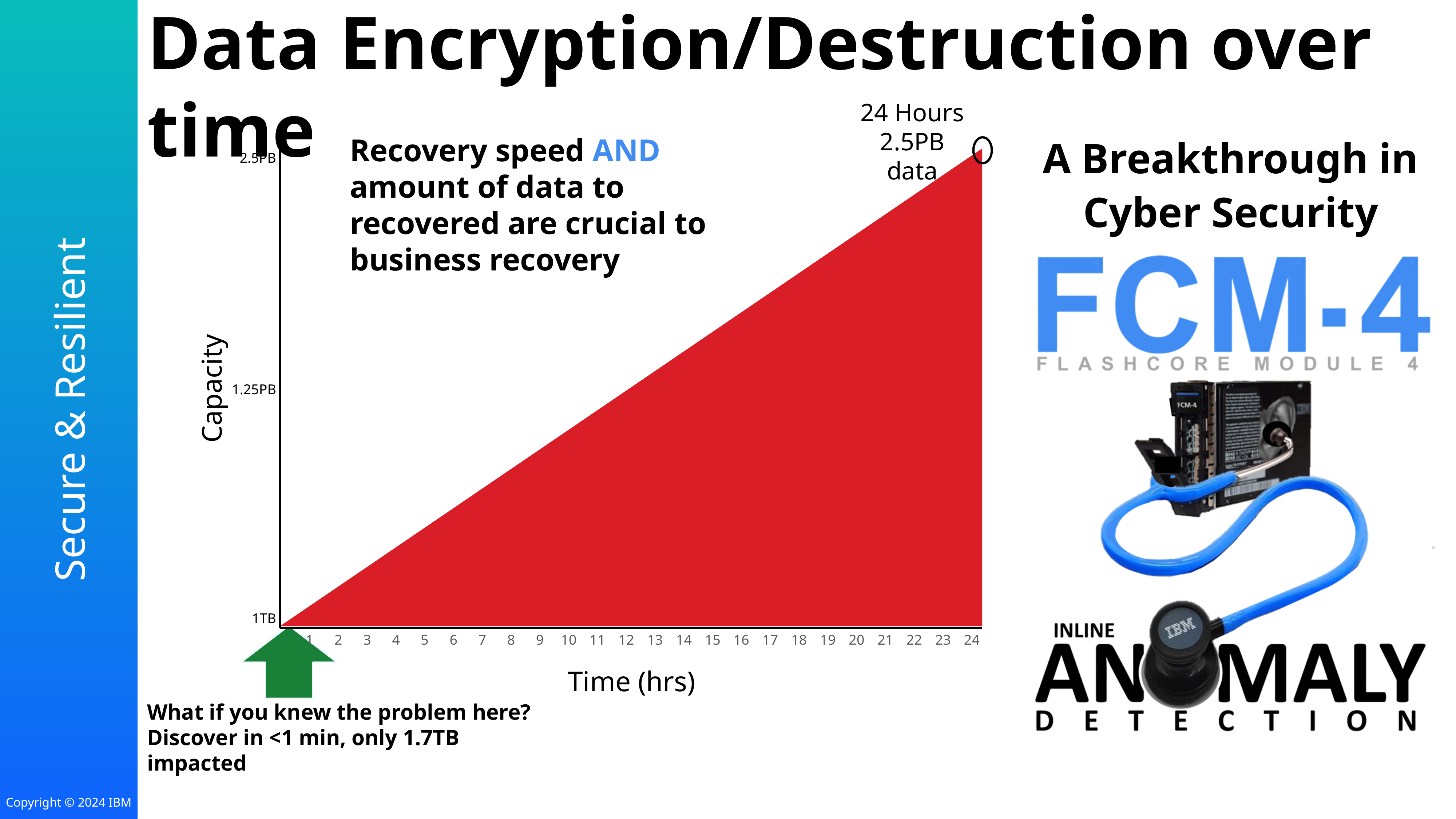
What is the title of the chart on the slide? Data Encryption/Destruction over time Does the plotted capacity rise or fall as time increases along the x axis? rise Which is larger, the plotted capacity at hour 20 or at hour 4? hour 20 What is the highest value labelled on the y axis of the chart? 2.5PB Is the plotted capacity at hour 6 greater or less than 1.25PB? less How many hour ticks are labelled along the x axis of the chart? 24 At which hour on the x axis does the plotted capacity reach its highest value? 24 What is the label of the x axis of the chart? Time (hrs) According to the annotation, how much data is affected at 24 hours? 2.5PB Is the plotted capacity at hour 18 greater or less than 1.25PB? greater What kind of chart is shown on the slide? area chart